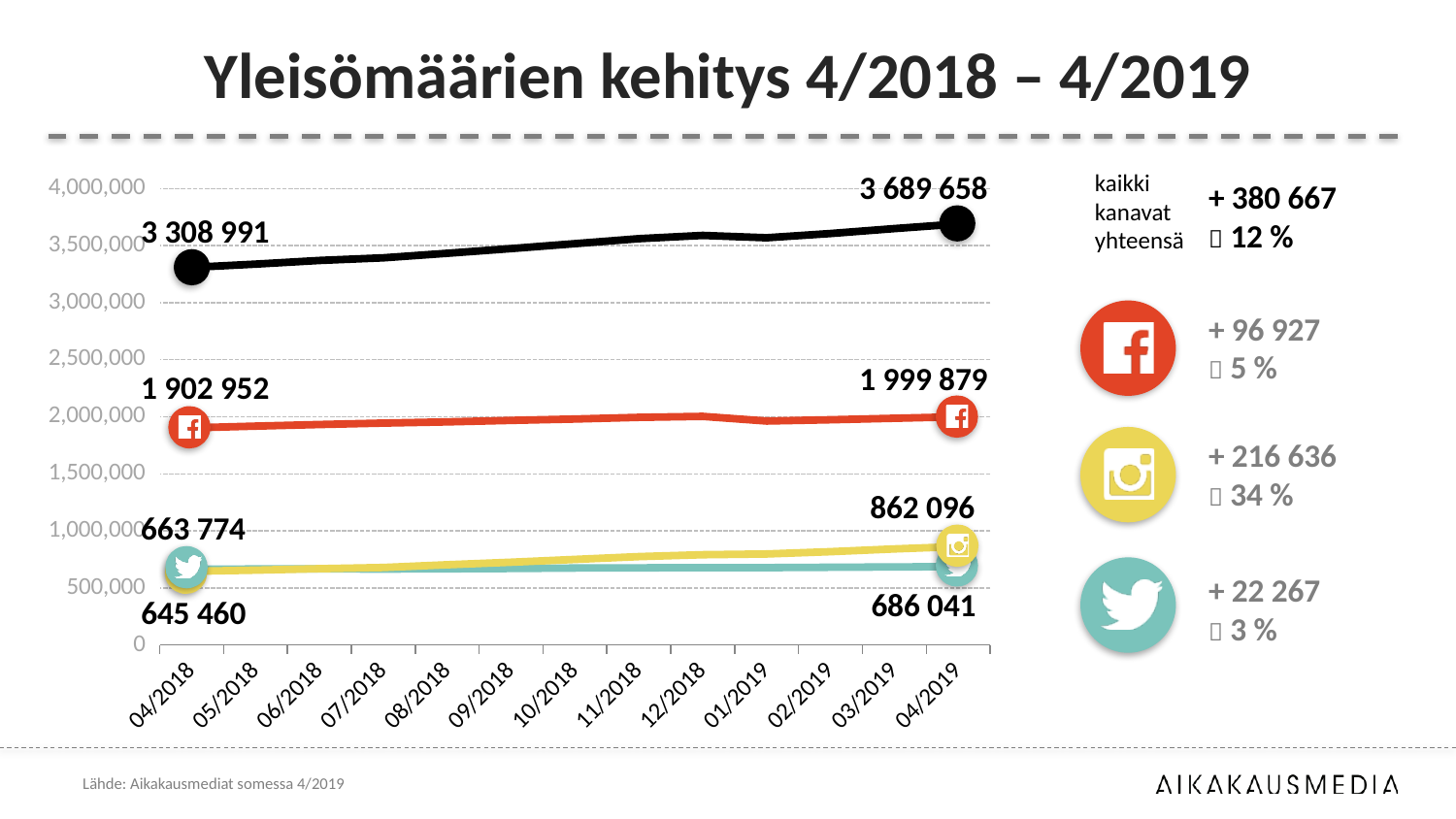
What is the value of the teal Twitter line at 04/2019? 686 041 What is the value of the red Facebook line at 04/2019? 1 999 879 What is the value of the black (total) line at 04/2019? 3 689 658 Which line has the highest value at 04/2019? the black (total) line How many months are shown on the x axis of the chart? 13 Does the red Facebook line rise or fall from 04/2018 to 04/2019? rise How many lines (series) are plotted on the chart? 4 What kind of chart is shown on the slide? line chart What is the title of the chart on the slide? Yleisömäärien kehitys 4/2018 – 4/2019 What is the value of the black (total) line at 04/2018? 3 308 991 What is the value of the yellow Instagram line at 04/2019? 862 096 By how much did the black (total) line increase from 04/2018 to 04/2019? 380 667